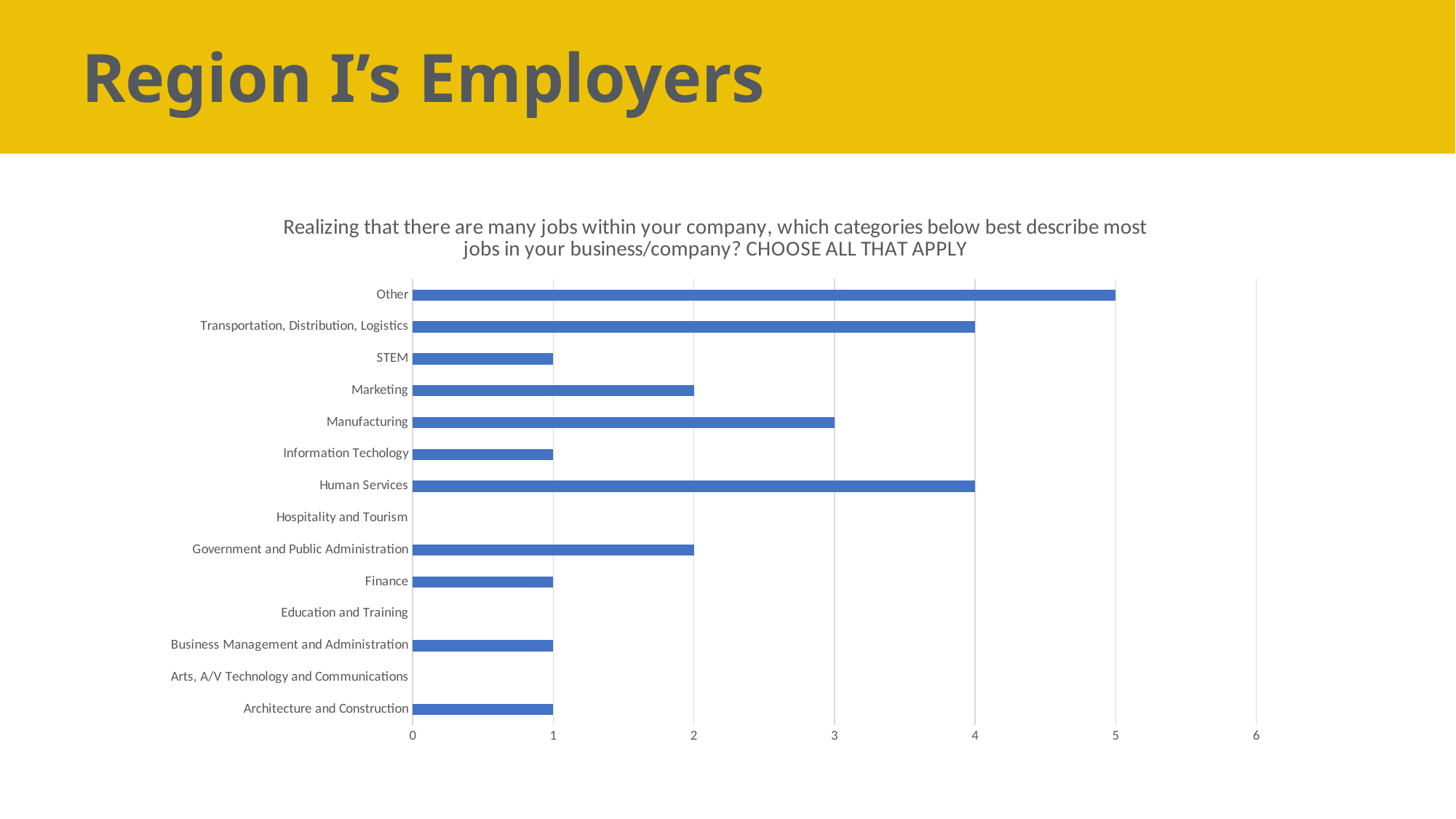
What type of chart is shown on the slide? Bar chart Which category has the highest value? Other What is the value for Human Services? 4 What is the value for Marketing? 2 What is the value for Other? 5 What is the value for Manufacturing? 3 Which is larger, the value for Transportation, Distribution, Logistics or the value for Marketing? Transportation, Distribution, Logistics Is the value for Other greater or less than 4? greater How many categories are listed on the chart? 14 What is the difference between the values for Other and Manufacturing? 2 What is the highest value shown on the horizontal axis? 6 What is the value for STEM? 1